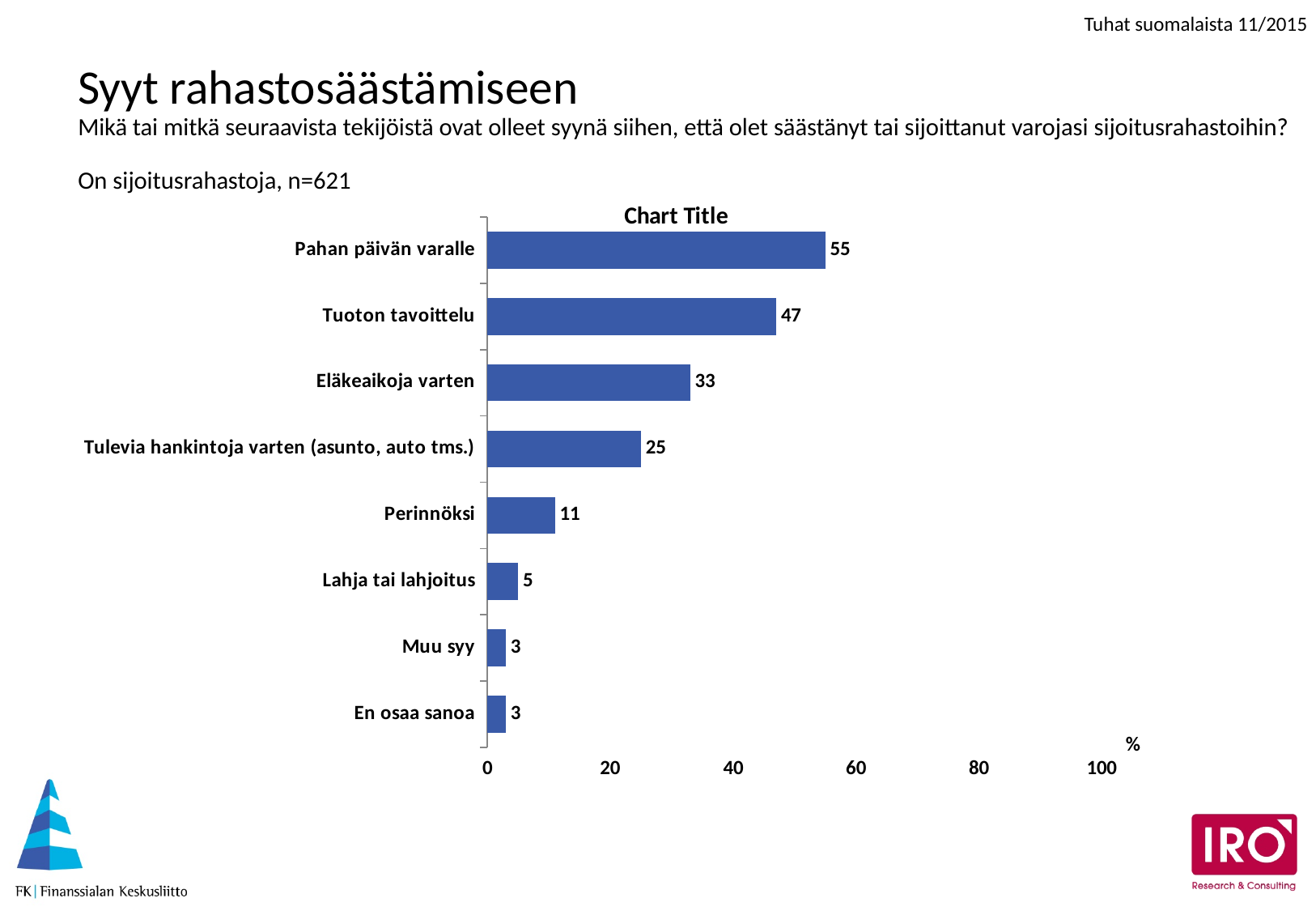
What is the value for "Pahan päivän varalle"? 55 What is the difference between the values for "Eläkeaikoja varten" and "Perinnöksi"? 22 What is the sample size (n) stated above the chart? n=621 What is the difference between the values for "Pahan päivän varalle" and "Tuoton tavoittelu"? 8 What is the value for "Eläkeaikoja varten"? 33 Which is larger, the value for "Tuoton tavoittelu" or the value for "Eläkeaikoja varten"? Tuoton tavoittelu What is the value for "Lahja tai lahjoitus"? 5 What is the value for "Tulevia hankintoja varten (asunto, auto tms.)"? 25 What kind of chart is shown on the slide? bar chart Is the value for "Tuoton tavoittelu" greater or less than 40? greater Which category has the highest value? Pahan päivän varalle How many categories are shown in the chart? 8